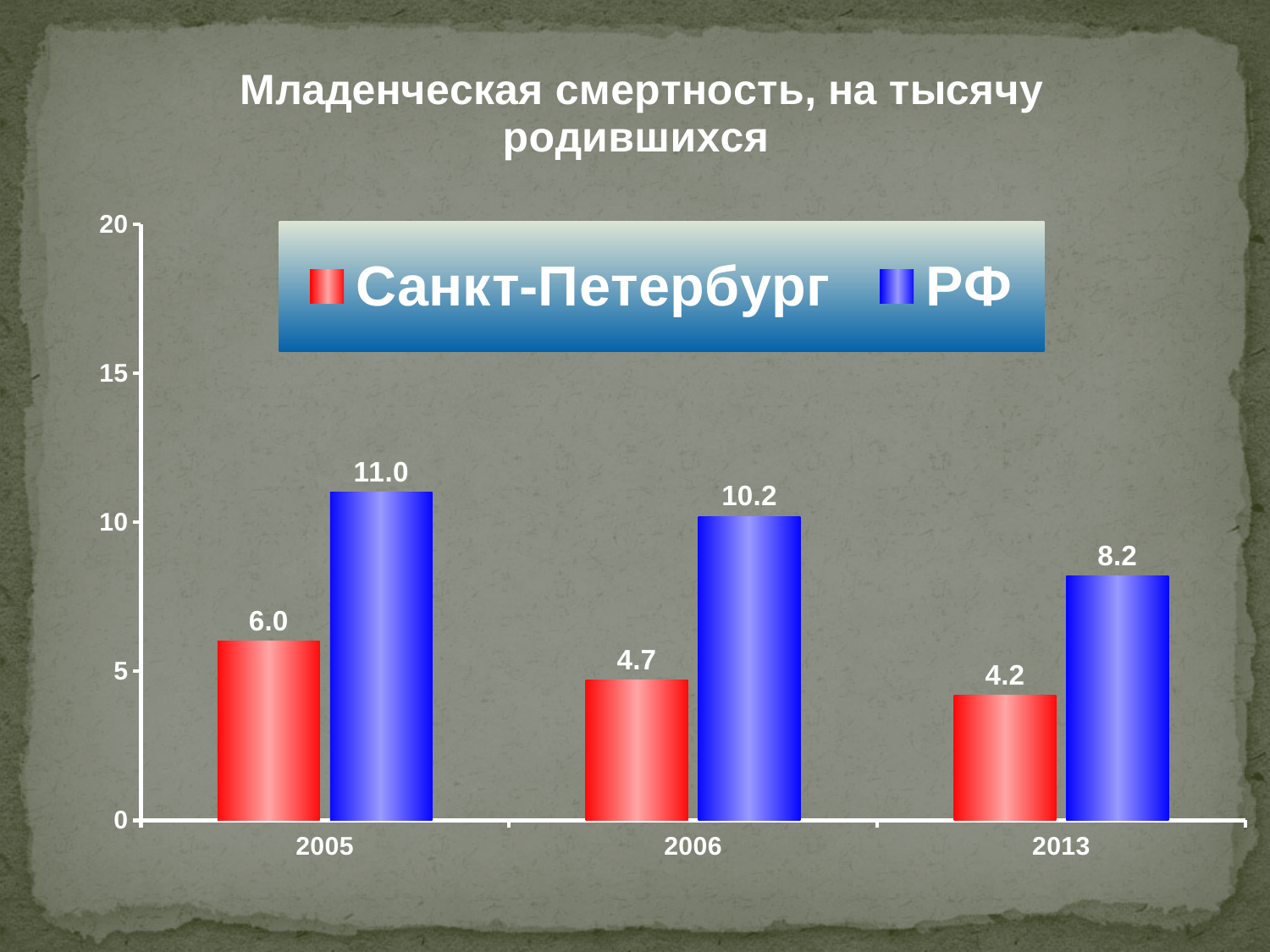
How many series does the legend list? 2 In which year is the Санкт-Петербург value lowest? 2013 Do the РФ values rise or fall from 2005 to 2013? fall What is the value for РФ in 2013? 8.2 What is the value for Санкт-Петербург in 2013? 4.2 What is the value for Санкт-Петербург in 2005? 6.0 Which is larger in 2006, the value for Санкт-Петербург or for РФ? РФ How many years are shown on the x axis? 3 What is the value for РФ in 2006? 10.2 In which year is the РФ value highest? 2005 What kind of chart is shown on the slide? bar chart What is the difference between the РФ and Санкт-Петербург values in 2005? 5.0